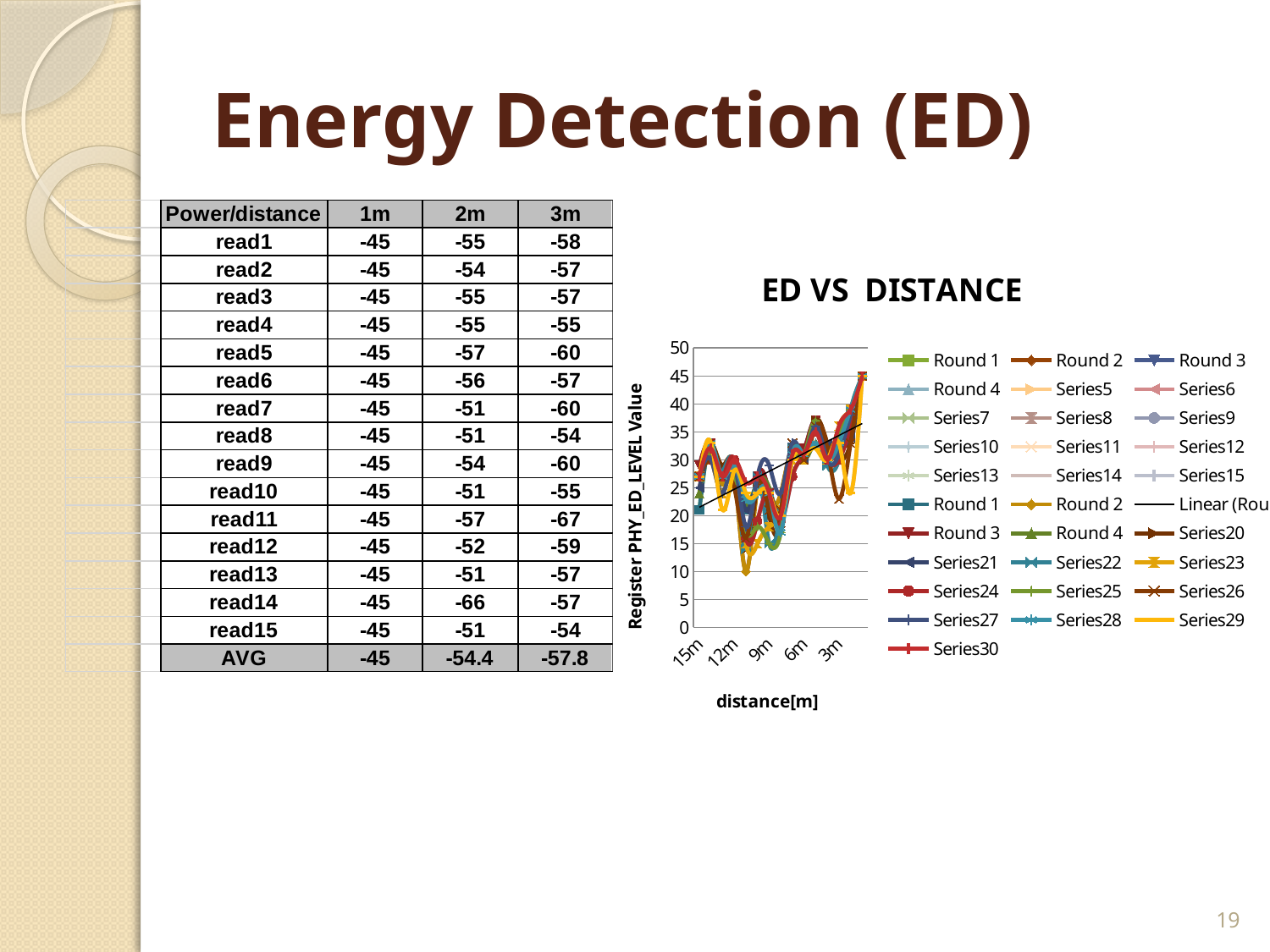
What is the first x-axis tick label on the left of the ED VS DISTANCE chart? 15m What is the title of the chart on the slide? ED VS DISTANCE What is the x-axis title of the ED VS DISTANCE chart? distance[m] How many entries does the legend of the ED VS DISTANCE chart list? 31 In the ED VS DISTANCE chart, are the values at 3m greater or less than 40? less How many tick labels are shown on the x axis of the ED VS DISTANCE chart? 5 What is the highest value shown on the y axis of the ED VS DISTANCE chart? 50 What kind of chart is shown on the slide? line chart In the ED VS DISTANCE chart, are the values at 15m greater or less than 40? less In the ED VS DISTANCE chart, does the linear trend line rise or fall from 15m to 3m? rise